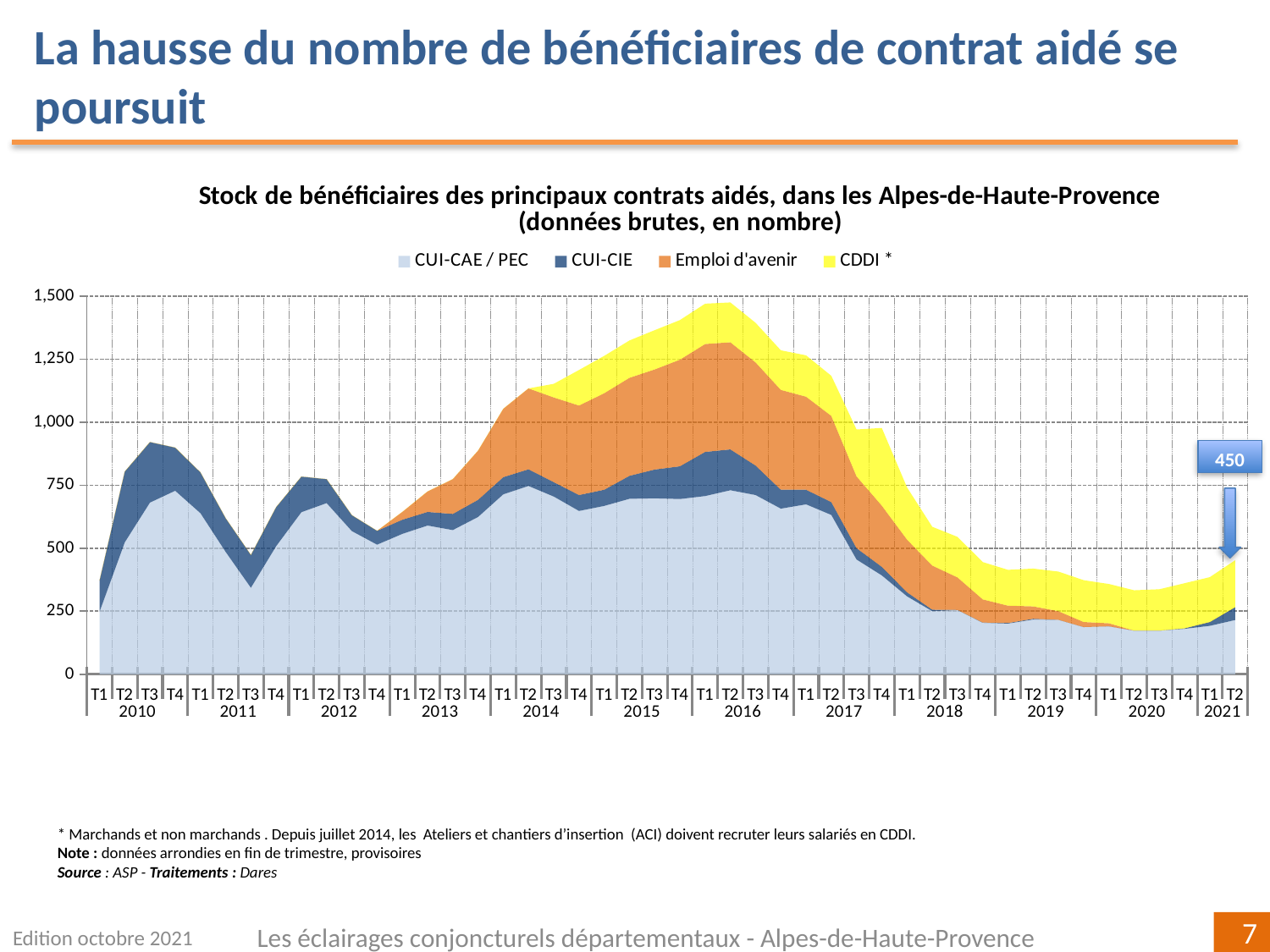
Which series forms the bottom layer of the stacked area chart? CUI-CAE / PEC What value does the callout label give for the total stock of beneficiaries in T2 2021? 450 Is the total stock of beneficiaries in T1 2010 greater or less than 500? less Is the total stock of beneficiaries in T1 2020 greater or less than 500? less Does the total stock of beneficiaries rise or fall between T2 2016 and T1 2020? fall Is the total stock of beneficiaries in T2 2016 greater or less than 1,250? greater How many series does the chart legend list? 4 How many years are labelled along the x axis of the chart? 12 What kind of chart is shown on the slide? Stacked area chart Which series is shown in yellow in the chart? CDDI * In which year does the total stock of beneficiaries reach its highest level? 2016 Which is larger, the total stock of beneficiaries in T2 2016 or in T2 2021? T2 2016